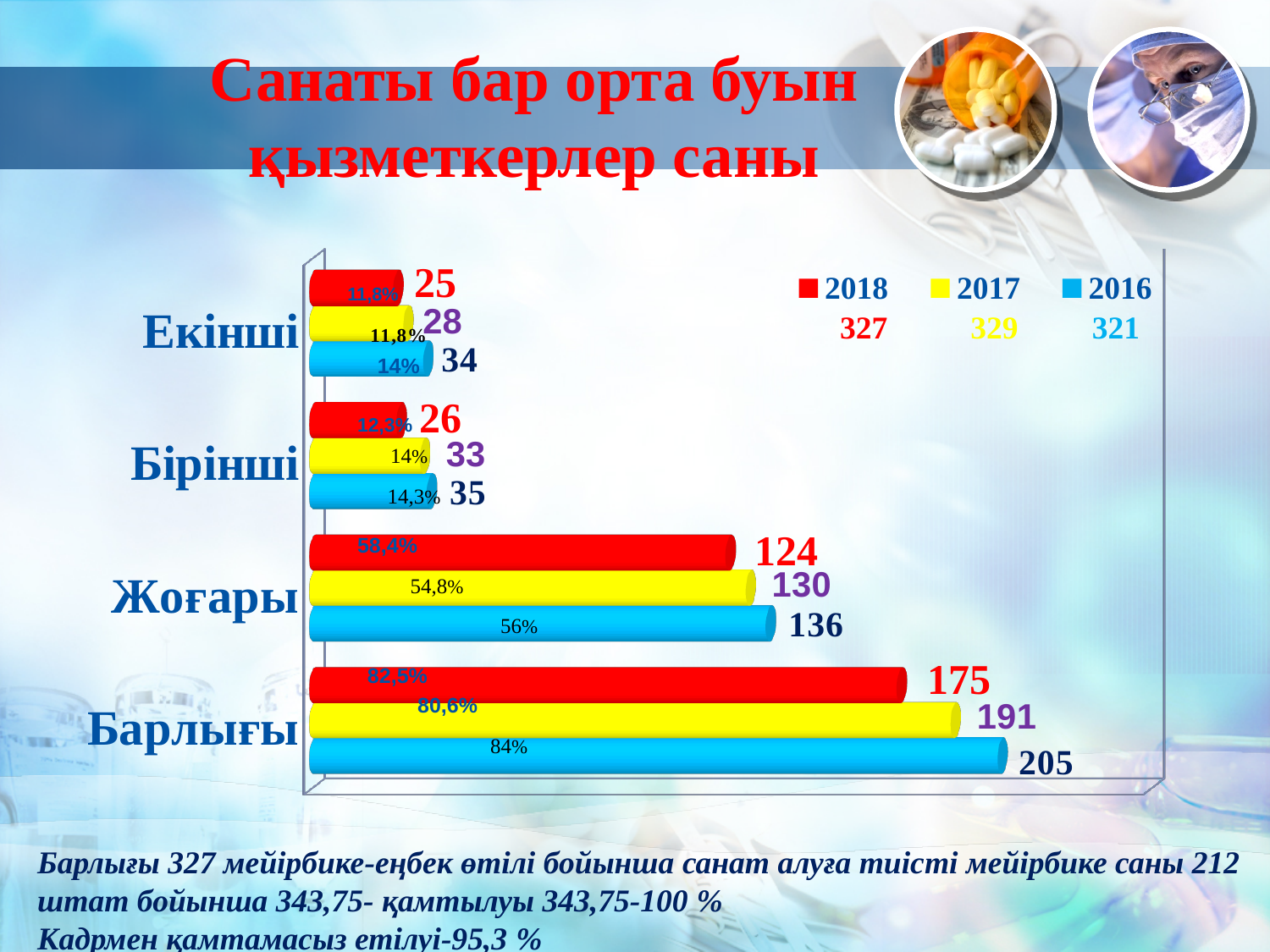
Which category has the highest value in the 2018 series? Барлығы How many series does the legend list? 3 Which is larger for Екінші: the 2017 value or the 2016 value? 2016 What kind of chart is shown on the slide? Bar chart What is the value for Барлығы in the 2016 series? 205 Which category has the lowest value in the 2016 series? Екінші What percentage label is shown on the 2016 bar for Жоғары? 56% How many categories are shown on the chart? 4 What is the difference between the 2016 and 2018 values for Барлығы? 30 What is the value for Бірінші in the 2017 series? 33 What is the value for Жоғары in the 2018 series? 124 What is the difference between the 2017 and 2018 values for Жоғары? 6